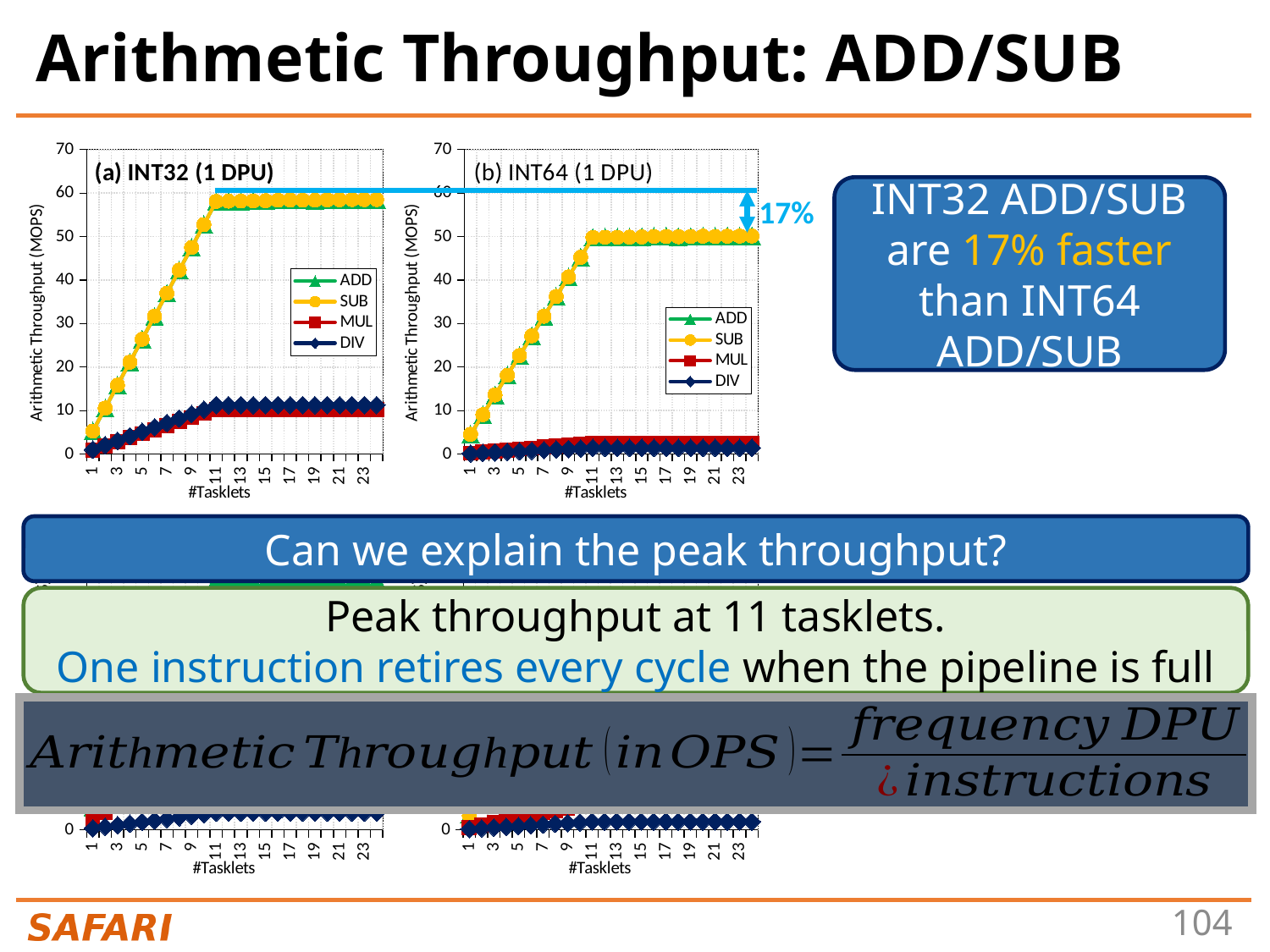
At 23 tasklets, is the ADD throughput higher in chart (a) INT32 (1 DPU) or chart (b) INT64 (1 DPU)? (a) INT32 (1 DPU) In chart (b) INT64 (1 DPU), is the ADD value at 23 tasklets greater or less than 60? less What is the y-axis label of chart (a) INT32 (1 DPU)? Arithmetic Throughput (MOPS) In chart (a) INT32 (1 DPU), at 23 tasklets, which is larger: ADD or MUL? ADD In chart (a) INT32 (1 DPU), how many series does the legend list? 4 In chart (a) INT32 (1 DPU), does the ADD series rise or fall as the number of tasklets goes from 1 to 11? rise In chart (b) INT64 (1 DPU), which series has the lowest value at 23 tasklets: SUB or DIV? DIV In chart (b) INT64 (1 DPU), is the MUL value at 23 tasklets greater or less than 10? less In chart (a) INT32 (1 DPU), is the ADD value at 23 tasklets greater or less than 50? greater What kind of chart is chart (a) INT32 (1 DPU)? line chart In chart (b) INT64 (1 DPU), what are the legend entries? ADD, SUB, MUL, DIV